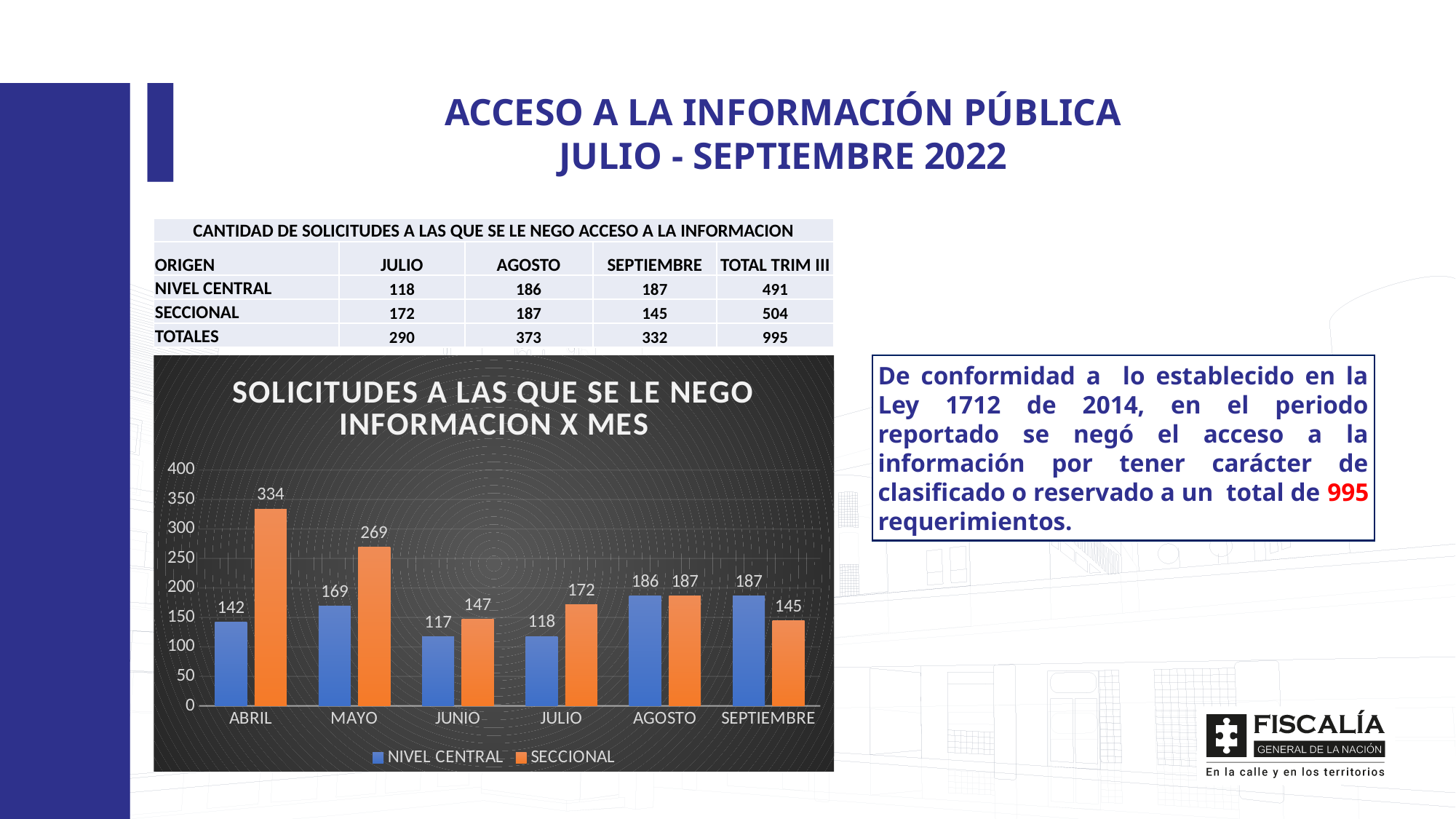
What is the value for SECCIONAL in ABRIL? 334 How many months are shown on the x axis of the chart? 6 Which month has the lowest NIVEL CENTRAL value? JUNIO Which month has the highest SECCIONAL value? ABRIL How many series does the chart legend list? 2 What is the value for SECCIONAL in SEPTIEMBRE? 145 What is the difference between the SECCIONAL and NIVEL CENTRAL values in ABRIL? 192 Which is larger in SEPTIEMBRE, NIVEL CENTRAL or SECCIONAL? NIVEL CENTRAL Which colour represents the SECCIONAL series in the chart? Orange Is the SECCIONAL value for MAYO greater or less than 250? greater What kind of chart is shown on the slide? Bar chart What is the value for NIVEL CENTRAL in JUNIO? 117